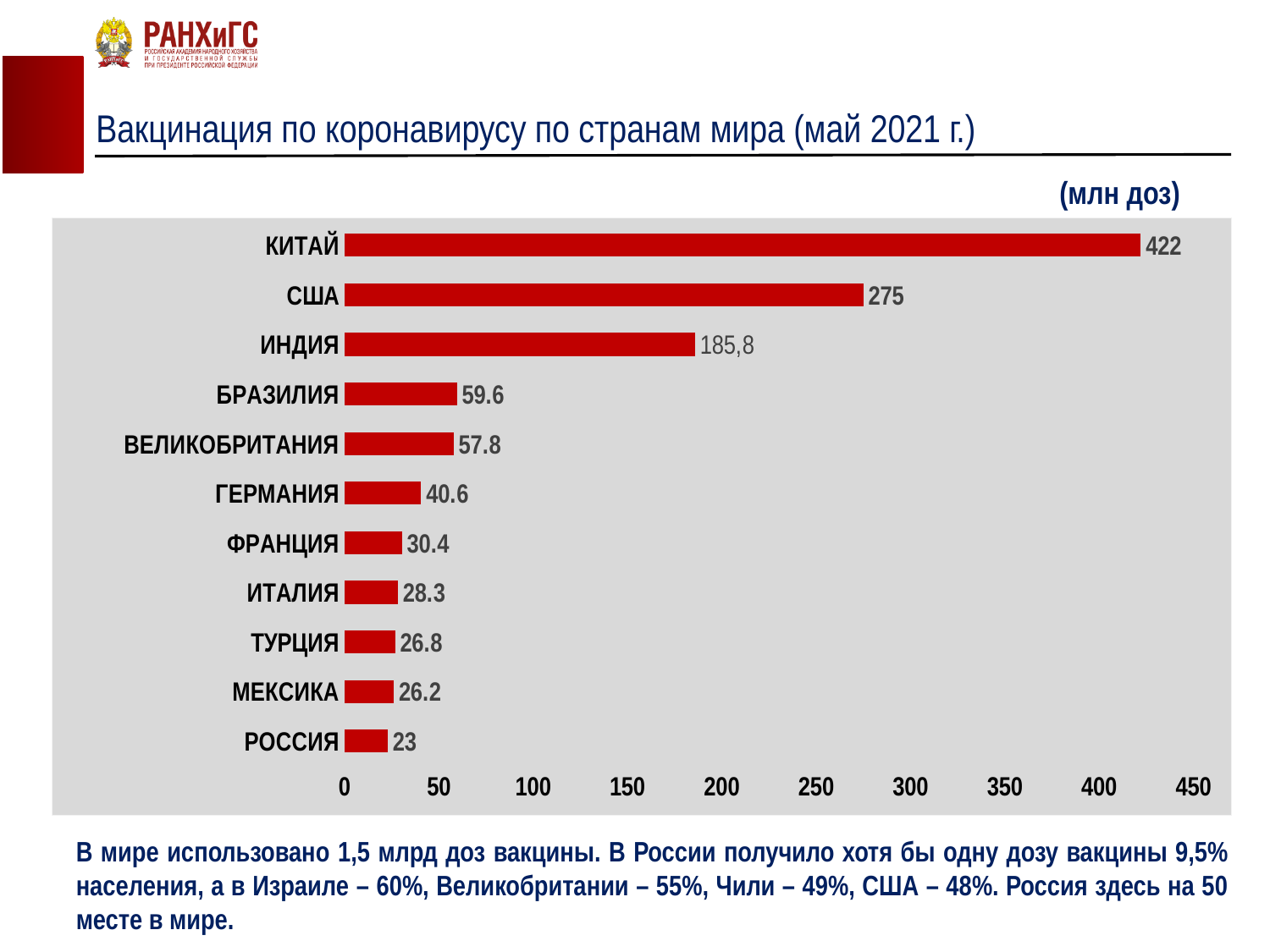
How many countries are shown in the chart? 11 What kind of chart is shown on the slide? bar chart Which country has the lowest value? РОССИЯ What unit is indicated above the chart? млн доз Which country has the highest value? КИТАЙ What is the difference between the values for КИТАЙ and США? 147 Is the value for ИНДИЯ greater or less than 150? greater What is the value for КИТАЙ? 422 What is the value for ИНДИЯ? 185,8 What is the value for США? 275 Which is larger, the value for ГЕРМАНИЯ or the value for ФРАНЦИЯ? ГЕРМАНИЯ What is the value for РОССИЯ? 23